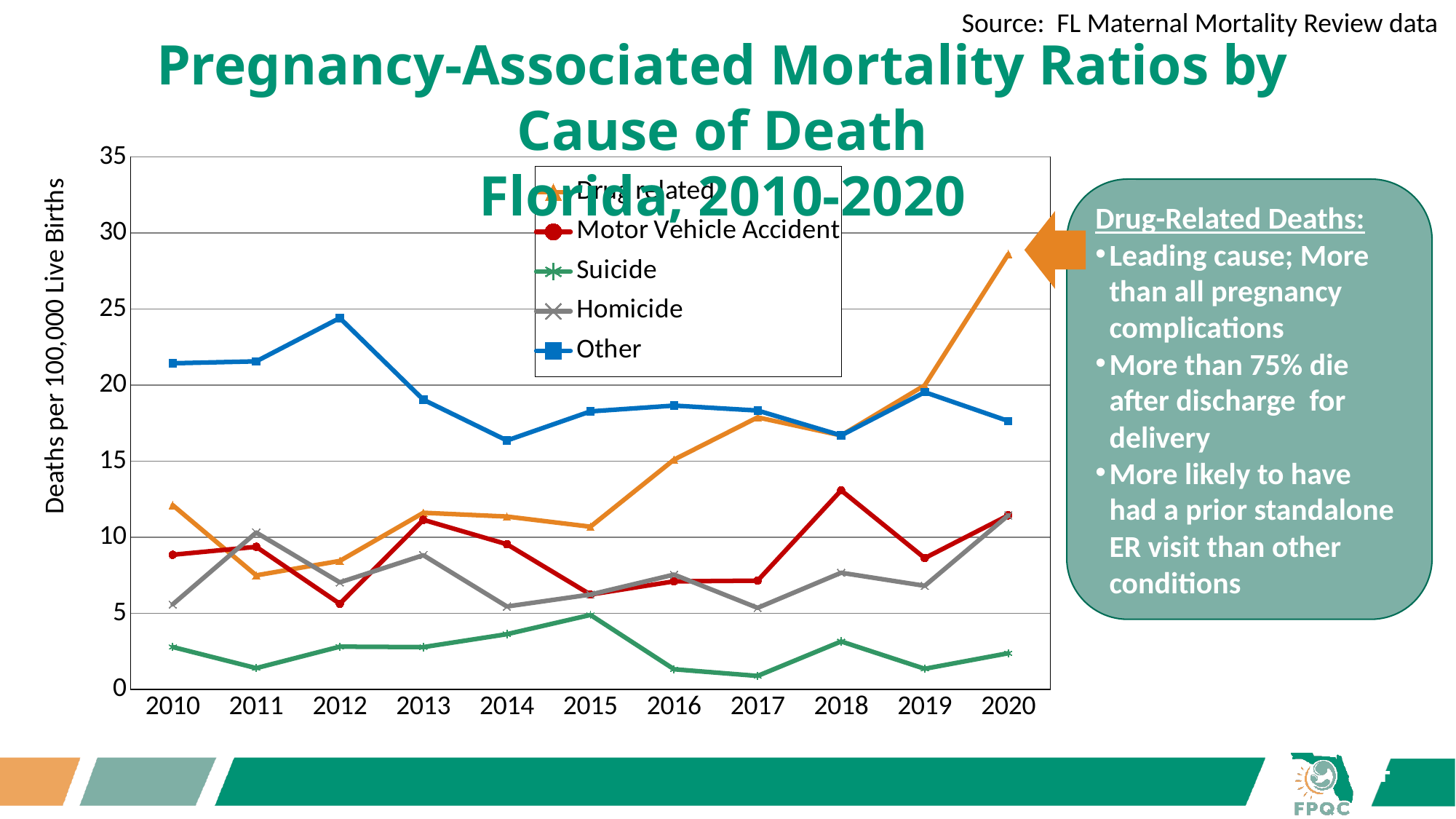
Is the value for Drug related in 2020 greater or less than 25? greater Is the value for Suicide in 2017 greater or less than 5? less Is the value for Other in 2012 greater or less than 20? greater What kind of chart is shown on the slide? Line chart Which series has the highest value in 2012? Other In 2010, which is larger: Other or Drug related? Other How many series does the legend list? 5 Does the Drug related line rise or fall from 2015 to 2020? Rises Which series has the lowest value in 2015? Suicide How many years are plotted along the x axis? 11 In 2020, which is larger: Drug related or Other? Drug related